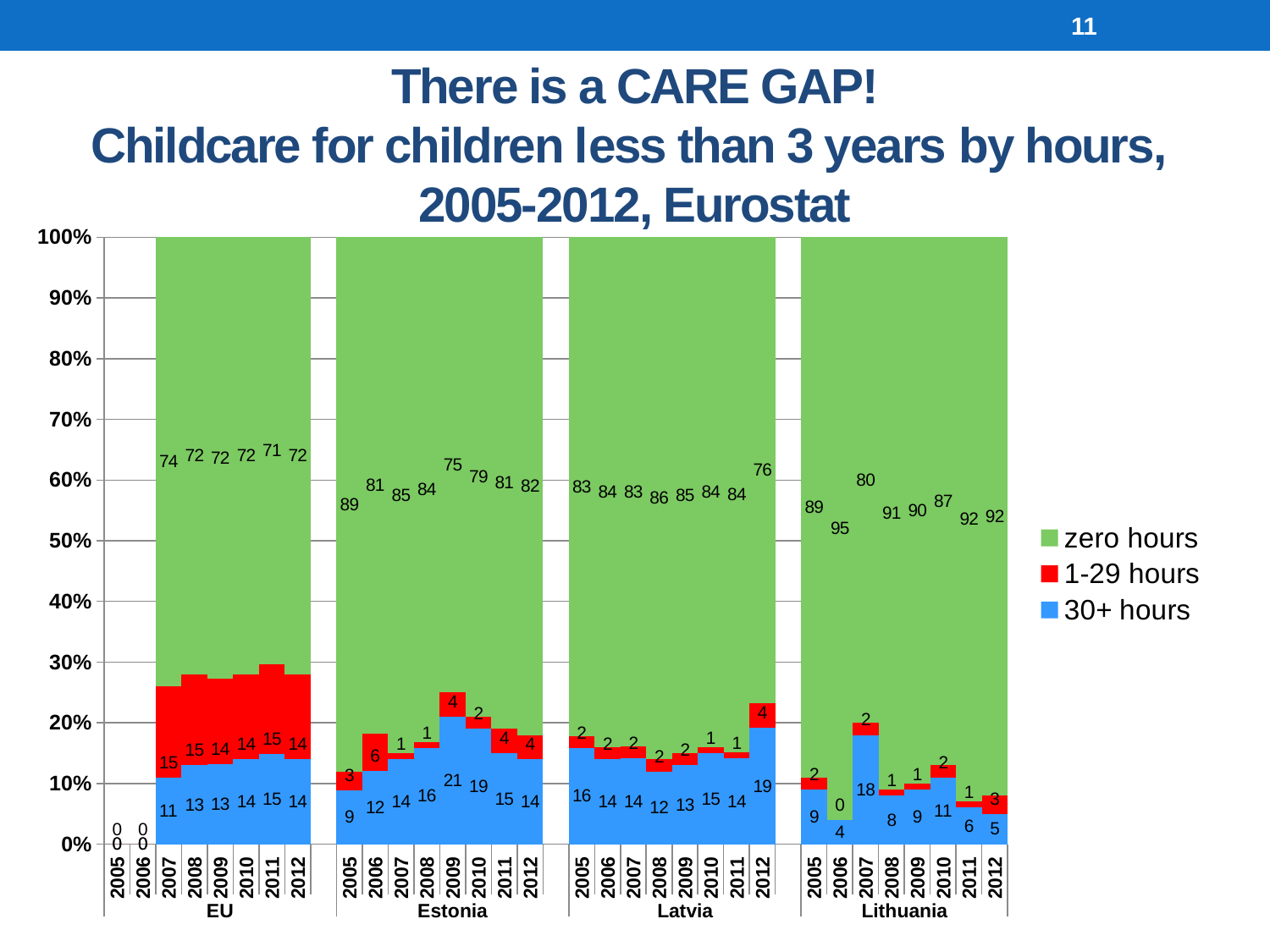
How many series does the legend list? 3 What is the value for 1-29 hours in the EU in 2011? 15 What is the difference between the zero hours values for Estonia in 2005 and 2009? 14 In which year is the zero hours value for Lithuania highest? 2006 What is the value for 30+ hours in Latvia in 2012? 19 What is the value for 30+ hours in Lithuania in 2007? 18 In which year is the 30+ hours value for Estonia lowest? 2005 Which is larger, the 30+ hours value for Latvia in 2012 or for Lithuania in 2012? Latvia in 2012 How many country groups are shown on the x axis? 4 Which colour represents the 1-29 hours series? Red What is the value for zero hours in Estonia in 2009? 75 What kind of chart is shown on the slide? Stacked bar chart